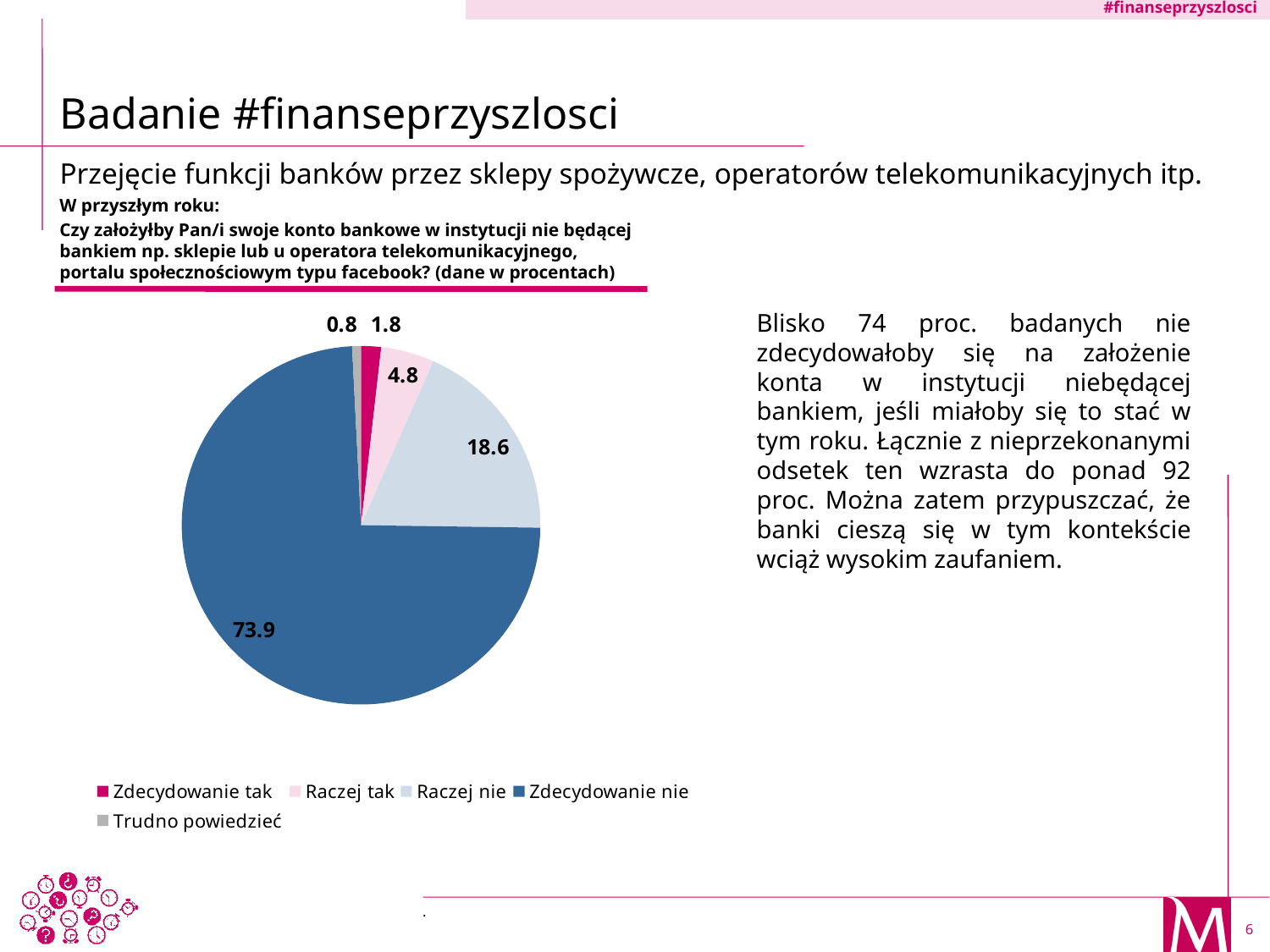
What is the difference between the values for "Zdecydowanie nie" and "Raczej nie"? 55.3 How many categories does the legend of the pie chart list? 5 Which is larger, the value for "Raczej tak" or the value for "Zdecydowanie tak"? Raczej tak What is the value for "Zdecydowanie nie" in the pie chart? 73.9 What is the value for "Zdecydowanie tak" in the pie chart? 1.8 Which category has the largest slice in the pie chart? Zdecydowanie nie What colour is the "Zdecydowanie nie" slice in the pie chart? Dark blue Which category has the smallest slice in the pie chart? Trudno powiedzieć What kind of chart is shown on the slide? Pie chart What is the value for "Raczej tak" in the pie chart? 4.8 What is the value for "Raczej nie" in the pie chart? 18.6 What is the value for "Trudno powiedzieć" in the pie chart? 0.8